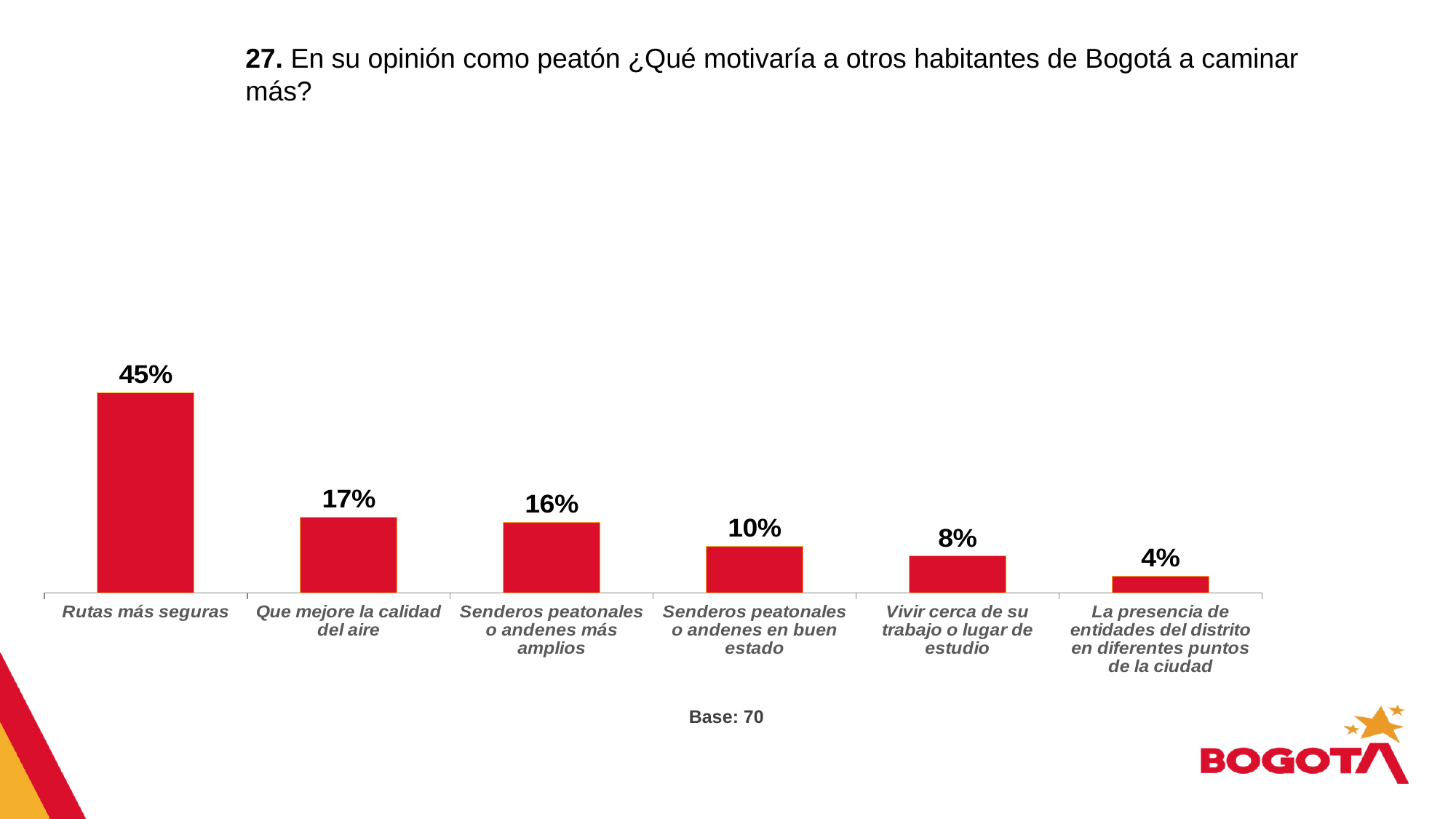
What is the difference between the values for "Vivir cerca de su trabajo o lugar de estudio" and "La presencia de entidades del distrito en diferentes puntos de la ciudad"? 4% Which category has the lowest value? La presencia de entidades del distrito en diferentes puntos de la ciudad What percentage is shown for "Que mejore la calidad del aire"? 17% Which category has the highest value? Rutas más seguras What percentage is shown for "La presencia de entidades del distrito en diferentes puntos de la ciudad"? 4% Which is larger, the value for "Senderos peatonales o andenes más amplios" or the value for "Senderos peatonales o andenes en buen estado"? Senderos peatonales o andenes más amplios What is the base (number of respondents) stated below the chart? Base: 70 What percentage is shown for "Senderos peatonales o andenes en buen estado"? 10% How many categories are shown in the chart? 6 What percentage is shown for "Rutas más seguras"? 45% What is the difference between the values for "Rutas más seguras" and "Que mejore la calidad del aire"? 28% What kind of chart is shown on the slide? Bar chart